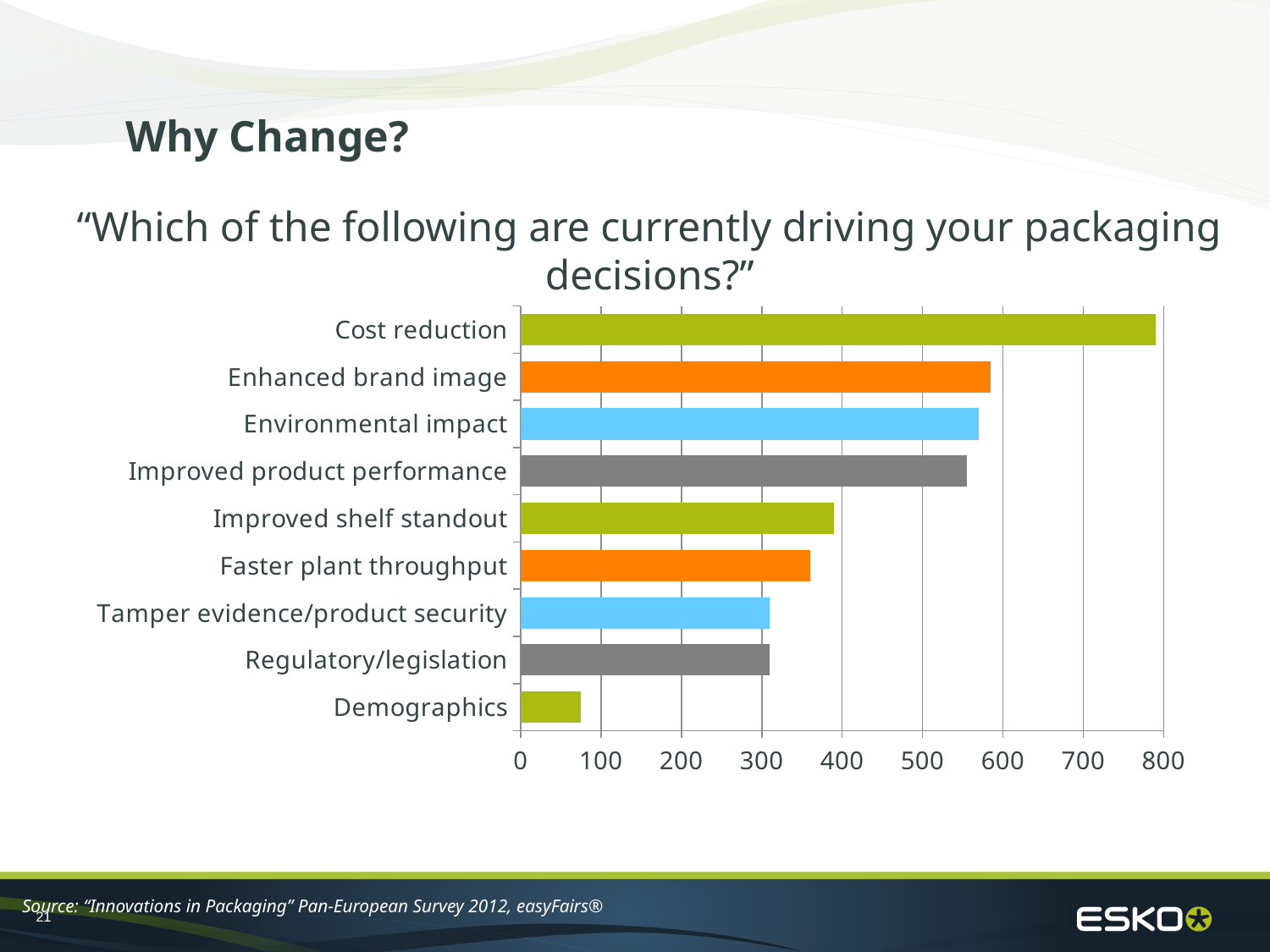
How many categories are plotted in the chart? 9 Which is larger, the value for Cost reduction or the value for Enhanced brand image? Cost reduction Is the value for Cost reduction greater or less than 700? greater Is the value for Demographics greater or less than 100? less What kind of chart is shown on the slide? bar chart Is the value for Improved product performance greater or less than 500? greater What is the title of the chart? "Which of the following are currently driving your packaging decisions?" Which category has the highest value? Cost reduction Which is larger, the value for Improved shelf standout or the value for Regulatory/legislation? Improved shelf standout Which category has the lowest value? Demographics